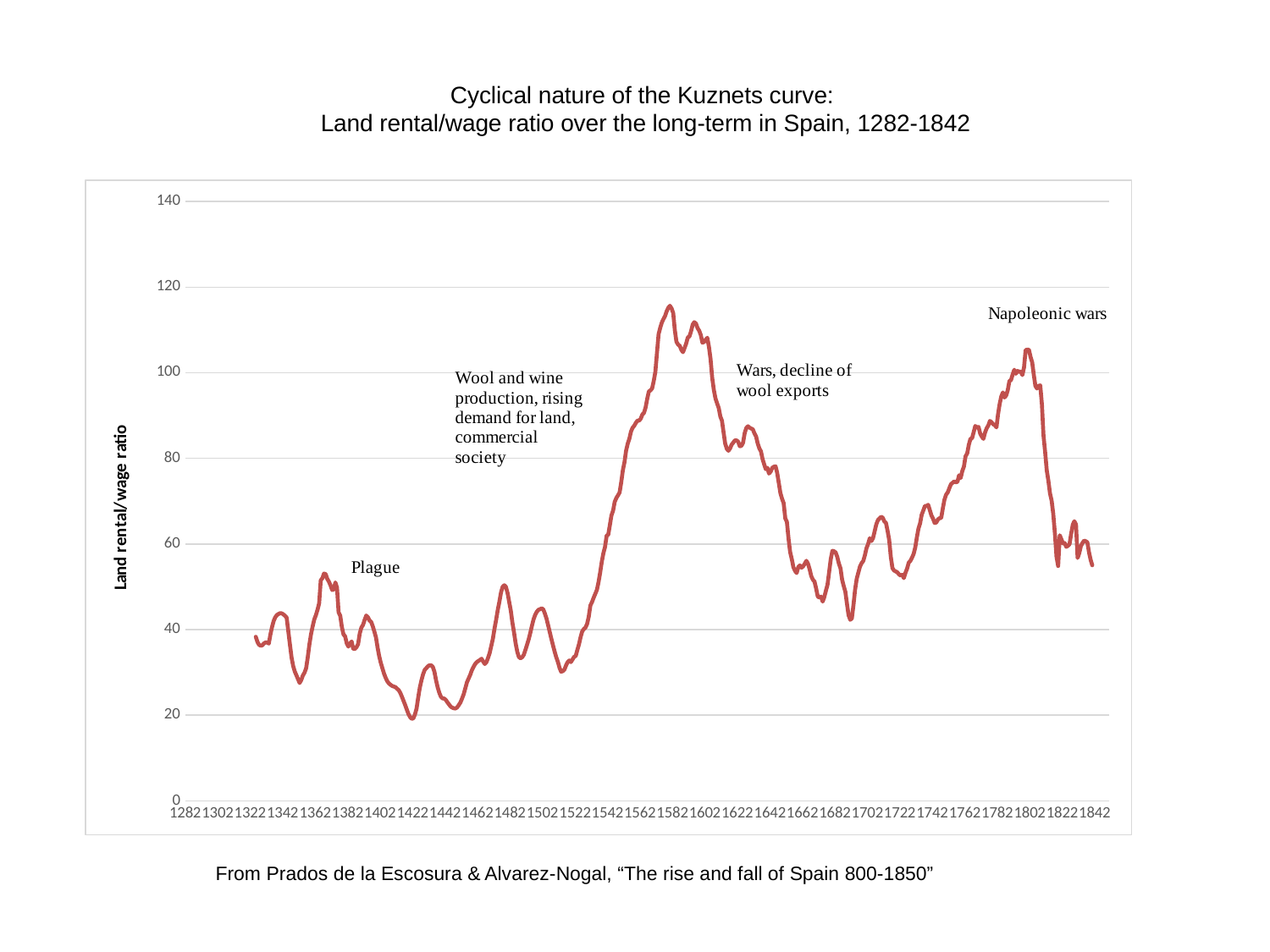
Does the land rental/wage ratio rise or fall between 1582 and 1682? fall Is the land rental/wage ratio in 1422 greater or less than 40? less Is the land rental/wage ratio in 1622 greater or less than 60? greater Does the land rental/wage ratio rise or fall between 1802 and 1842? fall Is the land rental/wage ratio in 1582 greater or less than 100? greater Does the land rental/wage ratio rise or fall between 1522 and 1582? rise What kind of chart is shown on the slide? Line chart Which annotation on the chart is placed near the peak at the right-hand end of the series? Napoleonic wars How many lines are plotted on the chart? 1 What is the label on the vertical axis of the chart? Land rental/wage ratio